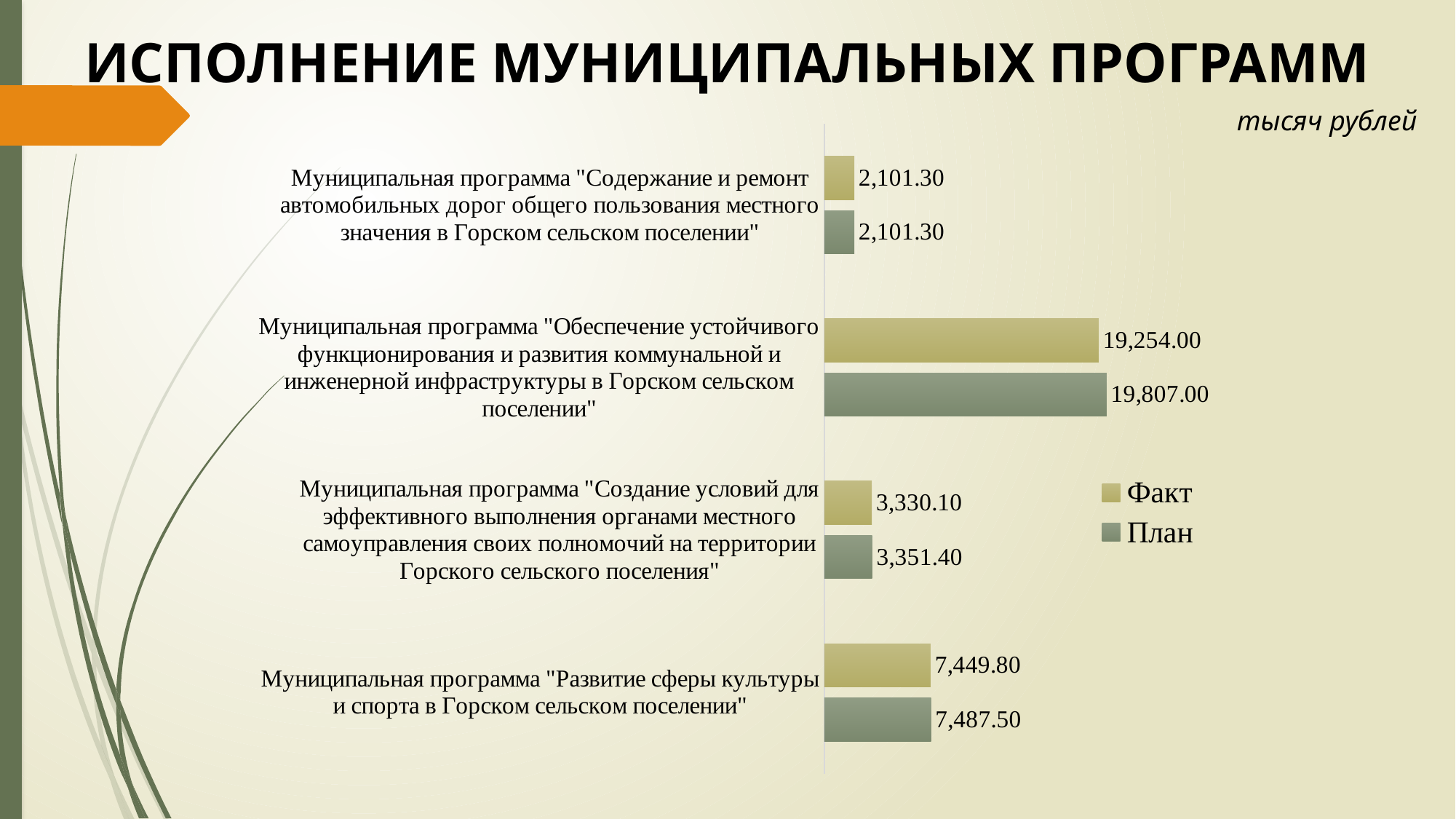
How many series does the legend list? 2 Which municipal program has the highest План value? Муниципальная программа "Обеспечение устойчивого функционирования и развития коммунальной и инженерной инфраструктуры в Горском сельском поселении" What is the Факт value for the program "Развитие сферы культуры и спорта в Горском сельском поселении"? 7,449.80 What is the План value for the program "Обеспечение устойчивого функционирования и развития коммунальной и инженерной инфраструктуры в Горском сельском поселении"? 19,807.00 What is the Факт value for the program "Содержание и ремонт автомобильных дорог общего пользования местного значения в Горском сельском поселении"? 2,101.30 What type of chart is shown on the slide? Bar chart What is the План value for the program "Создание условий для эффективного выполнения органами местного самоуправления своих полномочий на территории Горского сельского поселения"? 3,351.40 Which municipal program has the lowest Факт value? Муниципальная программа "Содержание и ремонт автомобильных дорог общего пользования местного значения в Горском сельском поселении" What is the difference between the План and Факт values for the program "Обеспечение устойчивого функционирования и развития коммунальной и инженерной инфраструктуры в Горском сельском поселении"? 553.00 What is the difference between the План and Факт values for the program "Развитие сферы культуры и спорта в Горском сельском поселении"? 37.70 What unit of measurement is indicated for the chart values? тысяч рублей How many municipal programs (categories) are shown in the chart? 4